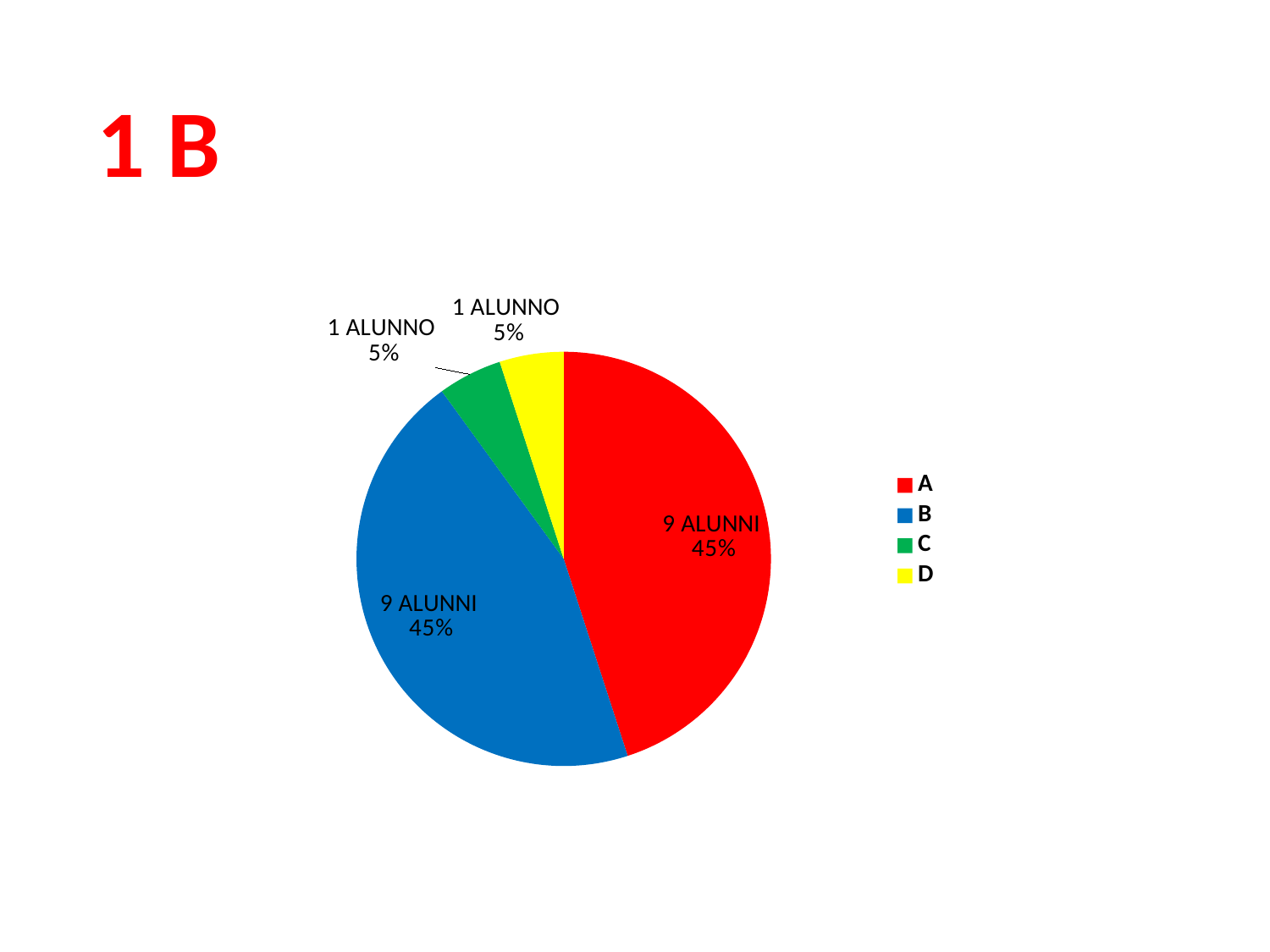
How many categories does the legend of the pie chart list? 4 What percentage share does category D have in the pie chart? 5% How many alunni are in category A according to the data label? 9 ALUNNI Which is larger, the share for category A or the share for category D? A What is the difference in percentage points between the share of category B and the share of category C? 40% How many alunni are in category C according to the data label? 1 ALUNNO What percentage share does category A have in the pie chart? 45% What percentage share does category B have in the pie chart? 45% What kind of chart is shown on the slide? pie chart What colour is the slice for category B in the pie chart? blue Which is larger, the share for category C or the share for category B? B